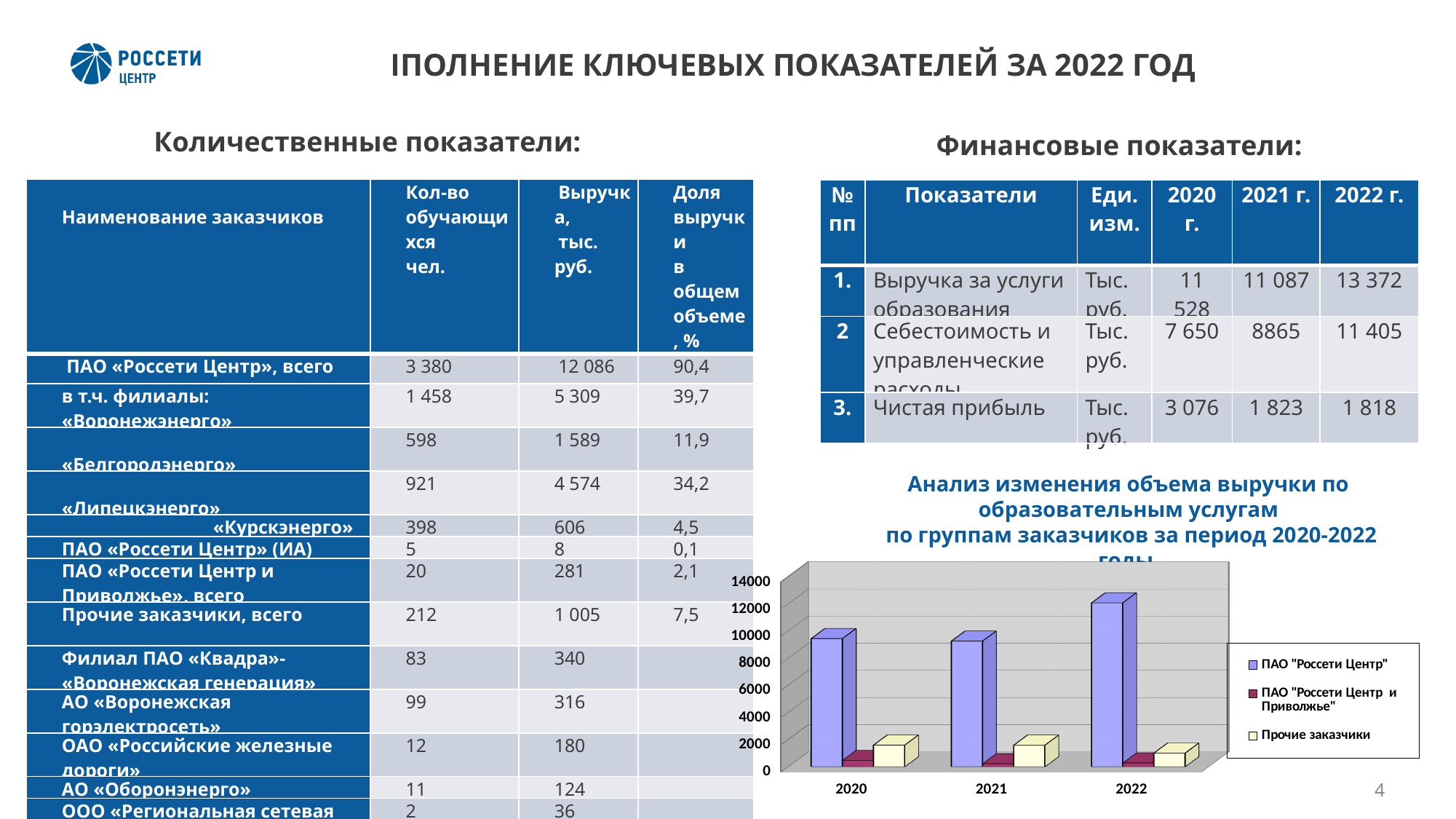
What kind of chart is shown on the slide? bar chart Which series has the highest bar in 2022? ПАО "Россети Центр" Which series has the lowest bars in every year of the chart? ПАО "Россети Центр и Приволжье" Which is larger: the bar for ПАО "Россети Центр" in 2022 or in 2020? 2022 In which year is the bar for ПАО "Россети Центр" the highest? 2022 How many series does the chart legend list? 3 Is the value for ПАО "Россети Центр" in 2020 greater or less than 8000? greater How many years are shown on the x axis of the chart? 3 Is the value for Прочие заказчики in 2022 greater or less than 4000? less Is the value for ПАО "Россети Центр" in 2022 greater or less than 10000? greater In 2021, which is larger: Прочие заказчики or ПАО "Россети Центр и Приволжье"? Прочие заказчики What colour are the bars for ПАО "Россети Центр" in the chart? blue (light purple-blue)